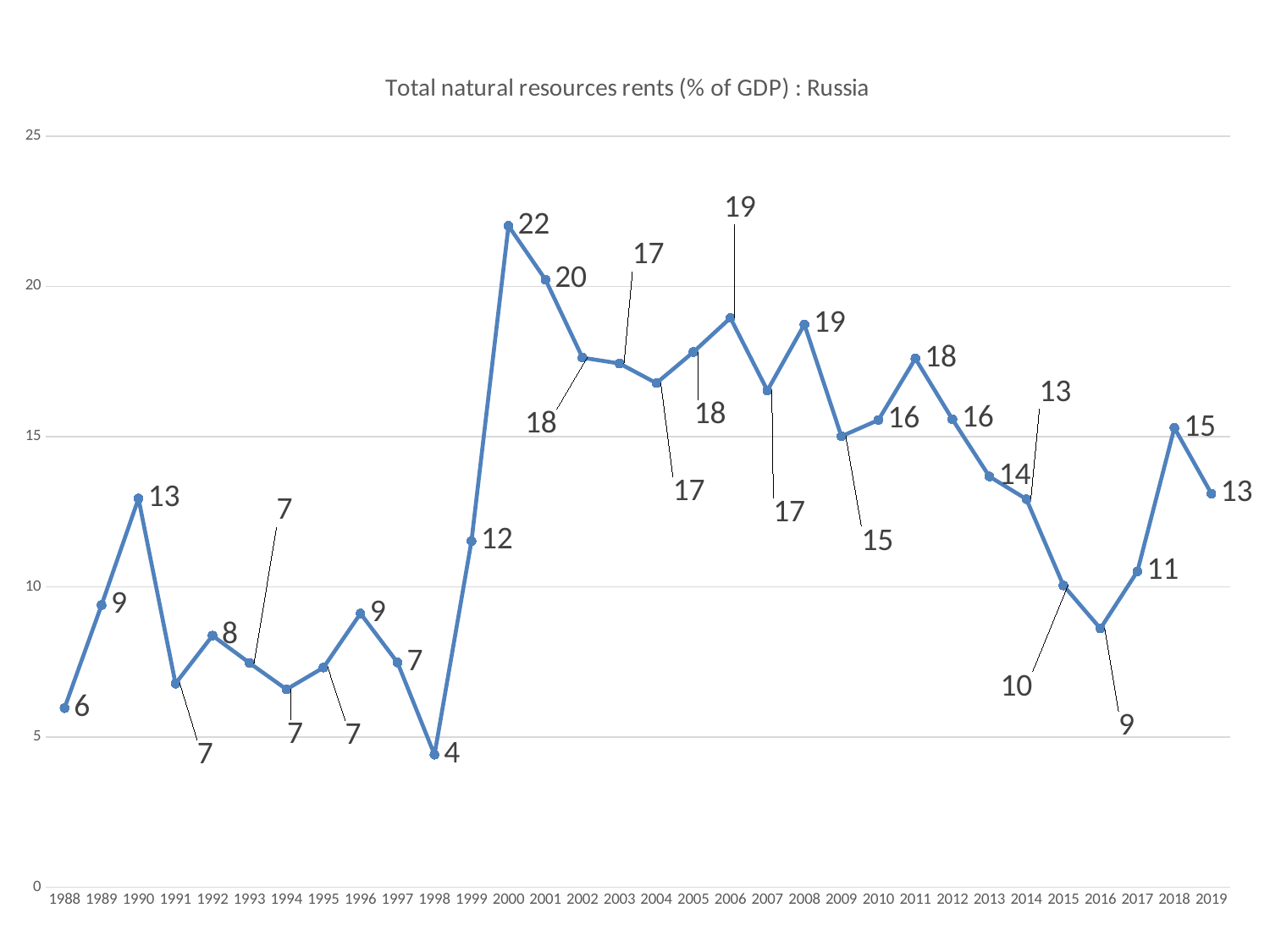
What is the difference between the values for 2000 and 1999? 10 What kind of chart is this? line chart What is the value for 2019? 13 Which year has the highest value? 2000 What is the value for 1988? 6 What is the value for 2000? 22 Which year has the lowest value? 1998 How many years are plotted on the chart? 32 What is the title of the chart? Total natural resources rents (% of GDP) : Russia Which is larger, the value for 2011 or the value for 2013? 2011 What is the value for 1998? 4 Is the value for 2001 greater or less than 15? greater